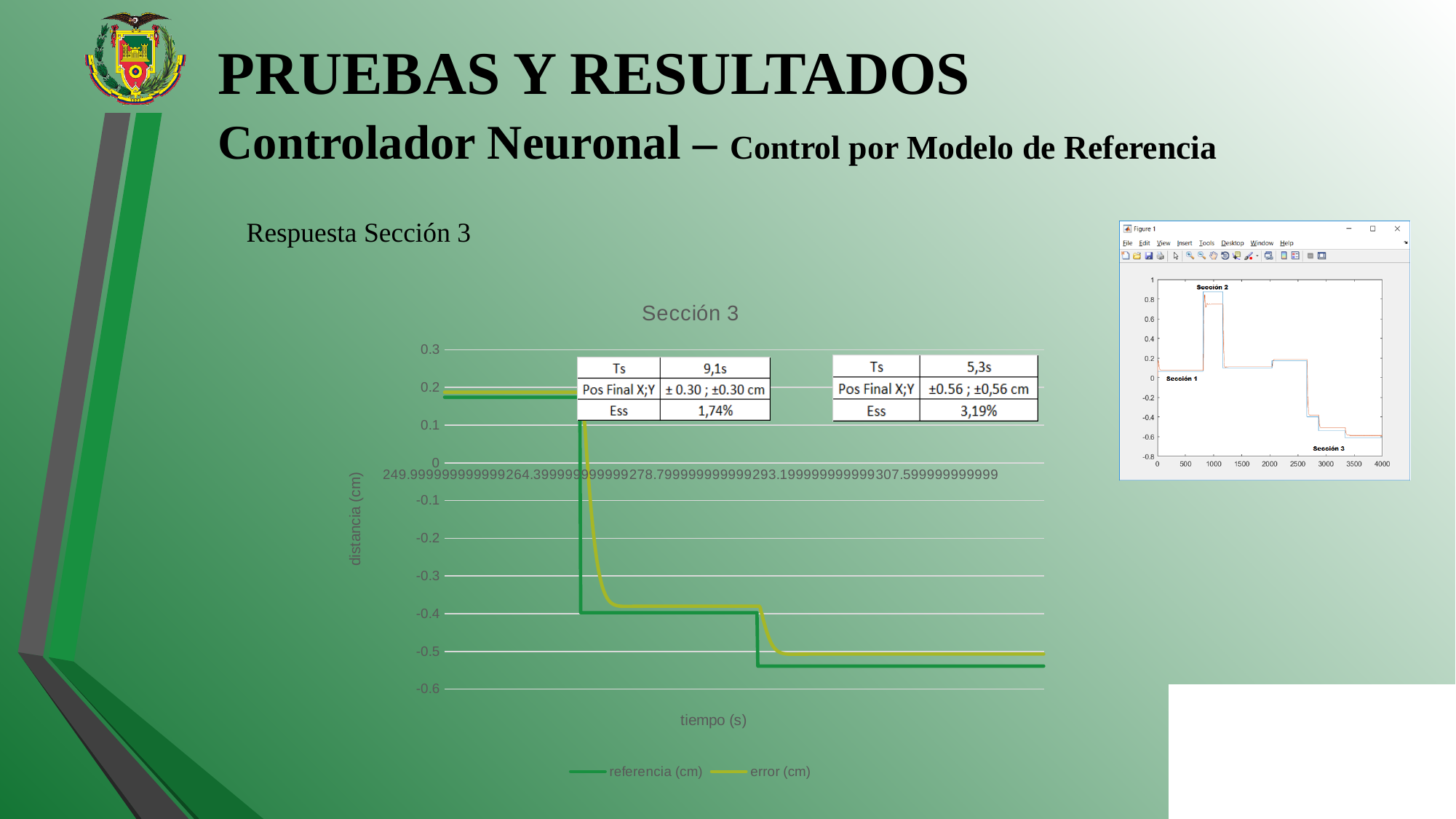
In the 'Sección 3' chart, how many series does the legend list? 2 In the 'Sección 3' chart, at the right end of the plot, which series has the higher value, referencia (cm) or error (cm)? error (cm) In the small MATLAB figure on the right, which labelled section reaches the highest values? Sección 2 In the 'Sección 3' chart, what are the two series named in the legend? referencia (cm) and error (cm) In the small MATLAB figure on the right, which labelled section has the lowest values? Sección 3 In the 'Sección 3' chart, do the values rise or fall along the x axis? fall In the 'Sección 3' chart, is the final value of error (cm) at the right end greater or less than -0.6? greater What kind of chart is the 'Sección 3' chart? line chart In the 'Sección 3' chart, is the final value of referencia (cm) at the right end greater or less than -0.5? less In the 'Sección 3' chart, what is the title of the vertical axis? distancia (cm) In the 'Sección 3' chart, is the value of referencia (cm) at the left start greater or less than 0.1? greater